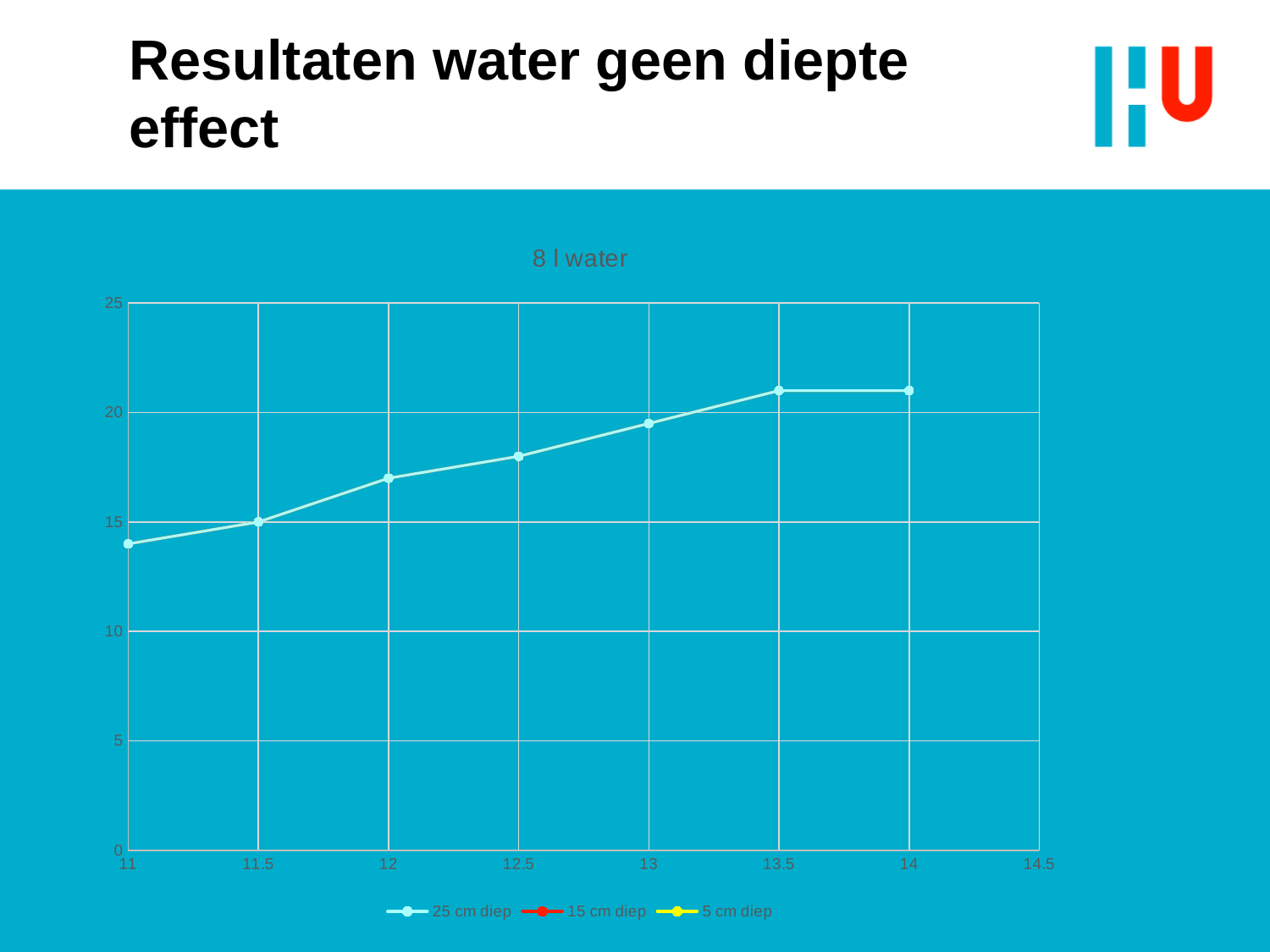
Is the value at x = 13 greater or less than 20? less What is the title of the chart? 8 l water Do the plotted values rise or fall as the x axis increases from 11 to 14? rise At which x value is the plotted value lowest? 11 Is the value at x = 11 greater or less than 15? less What kind of chart is shown on the slide? line chart Which series are listed in the legend? 25 cm diep, 15 cm diep, 5 cm diep How many data points are plotted on the visible line? 7 Is the value at x = 14 greater or less than 20? greater How many series does the legend list? 3 Which is larger, the value at x = 12 or the value at x = 13? x = 13